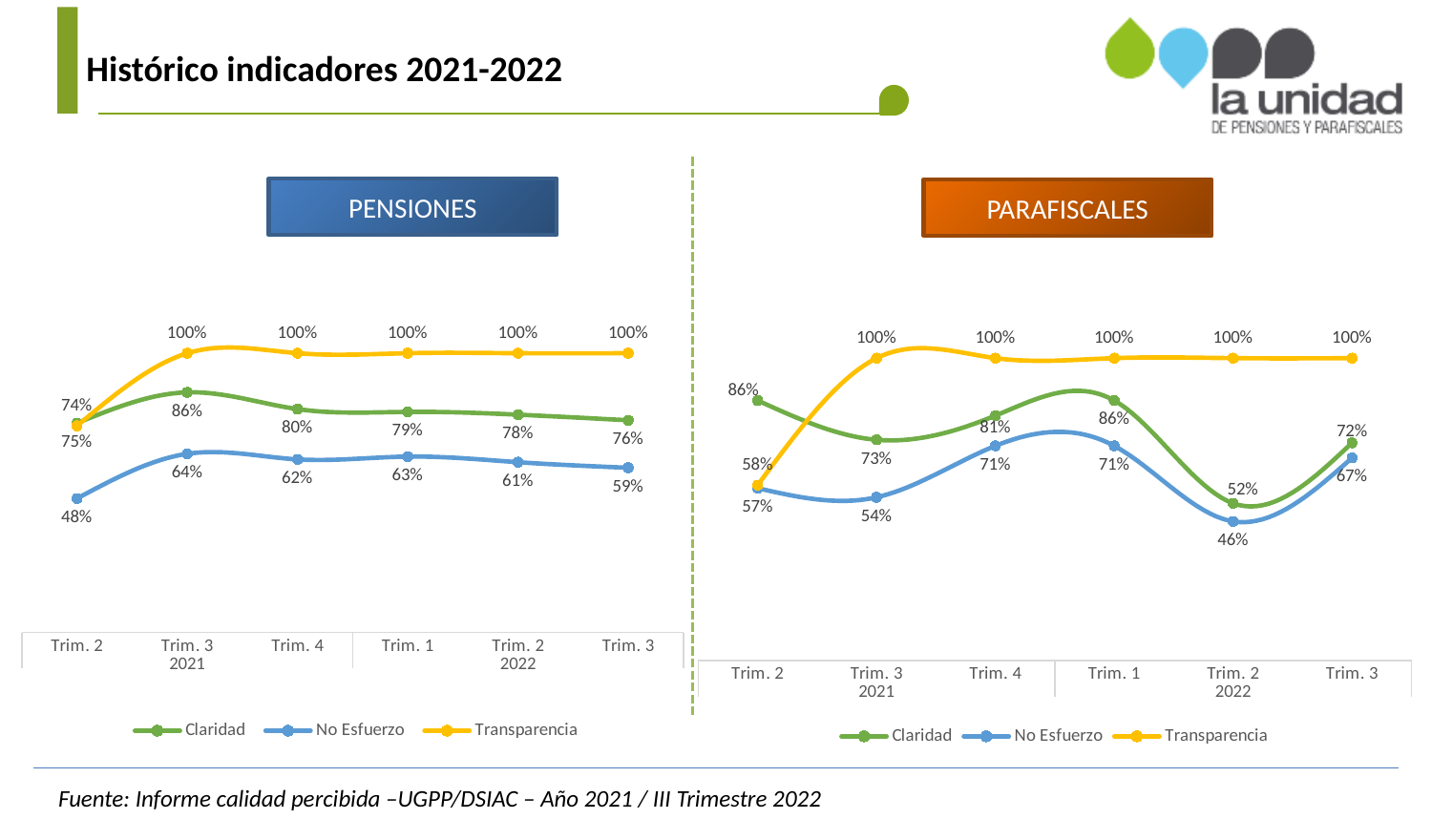
In the PENSIONES chart, what is the value of No Esfuerzo in Trim. 3 2022? 59% What type of chart is the PENSIONES chart? Line chart In the PARAFISCALES chart, which is larger in Trim. 3 2022: Claridad or No Esfuerzo? Claridad In the PENSIONES chart, does Claridad rise or fall from Trim. 3 2021 to Trim. 3 2022? Fall In the PENSIONES chart, what is the value of No Esfuerzo in Trim. 2 2021? 48% In the PARAFISCALES chart, what is the value of Claridad in Trim. 2 2022? 52% In the PENSIONES chart, what is the difference between Claridad and No Esfuerzo in Trim. 4 2021? 18% In the PARAFISCALES chart, in which quarter does No Esfuerzo reach its lowest value? Trim. 2 2022 In the PENSIONES chart, what is the value of Claridad in Trim. 3 2021? 86% In the PARAFISCALES chart, what is the value of No Esfuerzo in Trim. 3 2021? 54% How many quarters are plotted on the x axis of the PENSIONES chart? 6 How many series does the legend of the PARAFISCALES chart list? 3